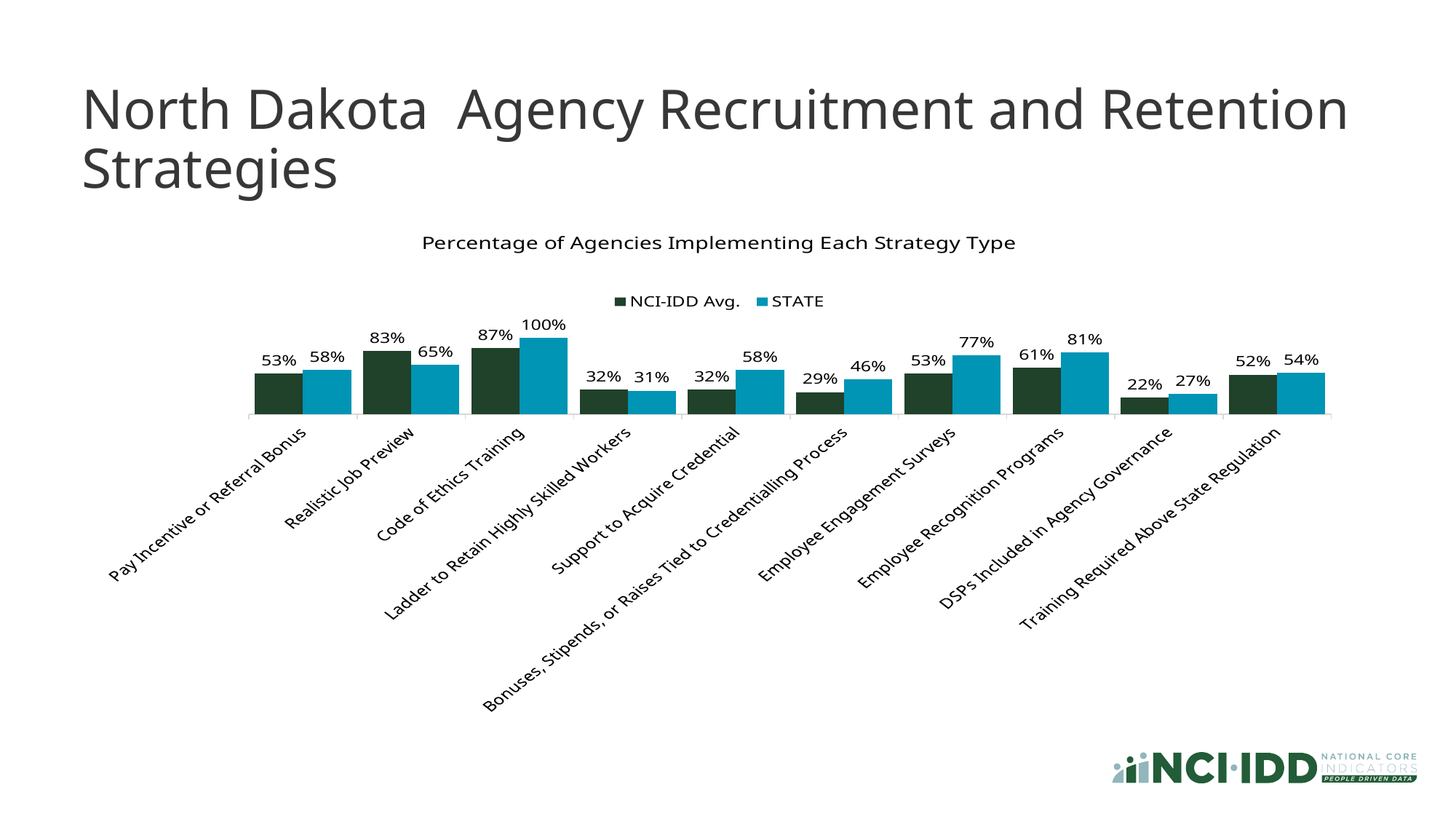
What is the difference between the STATE and NCI-IDD Avg. values for Employee Engagement Surveys? 24% Which is larger for Ladder to Retain Highly Skilled Workers, the NCI-IDD Avg. value or the STATE value? NCI-IDD Avg. What is the difference between the STATE and NCI-IDD Avg. values for Support to Acquire Credential? 26% Which category has the highest STATE value? Code of Ethics Training What is the title of the chart? Percentage of Agencies Implementing Each Strategy Type What is the STATE value for Code of Ethics Training? 100% What kind of chart is shown on the slide? Bar chart What is the STATE value for Bonuses, Stipends, or Raises Tied to Credentialling Process? 46% What is the NCI-IDD Avg. value for Realistic Job Preview? 83% How many series does the legend list? 2 Which category has the lowest NCI-IDD Avg. value? DSPs Included in Agency Governance How many strategy categories are shown on the chart? 10